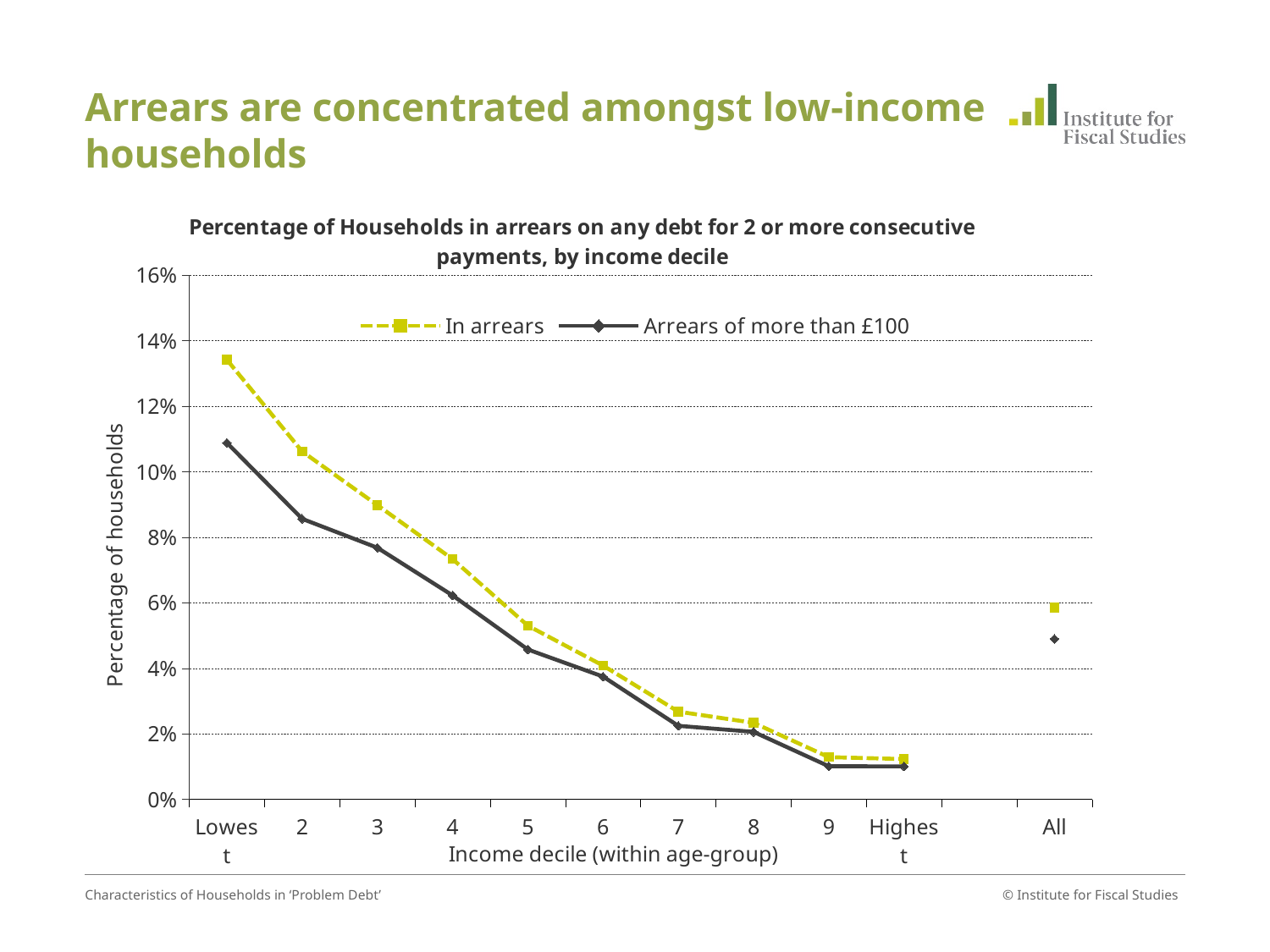
Is the 'Arrears of more than £100' value for the Lowest income decile greater or less than 10%? greater How many categories are shown along the x axis, including 'All'? 11 What is the label of the y axis? Percentage of households How many series does the legend list? 2 What kind of chart is shown on the slide? line chart Which income decile has the highest value for the 'In arrears' series? Lowest Is the 'Arrears of more than £100' value for 'All' greater or less than 4%? greater Do the 'In arrears' values rise or fall as the income decile increases from Lowest to Highest? fall Is the 'In arrears' value for the Lowest income decile greater or less than 12%? greater At the Lowest income decile, which series has the larger value: 'In arrears' or 'Arrears of more than £100'? In arrears